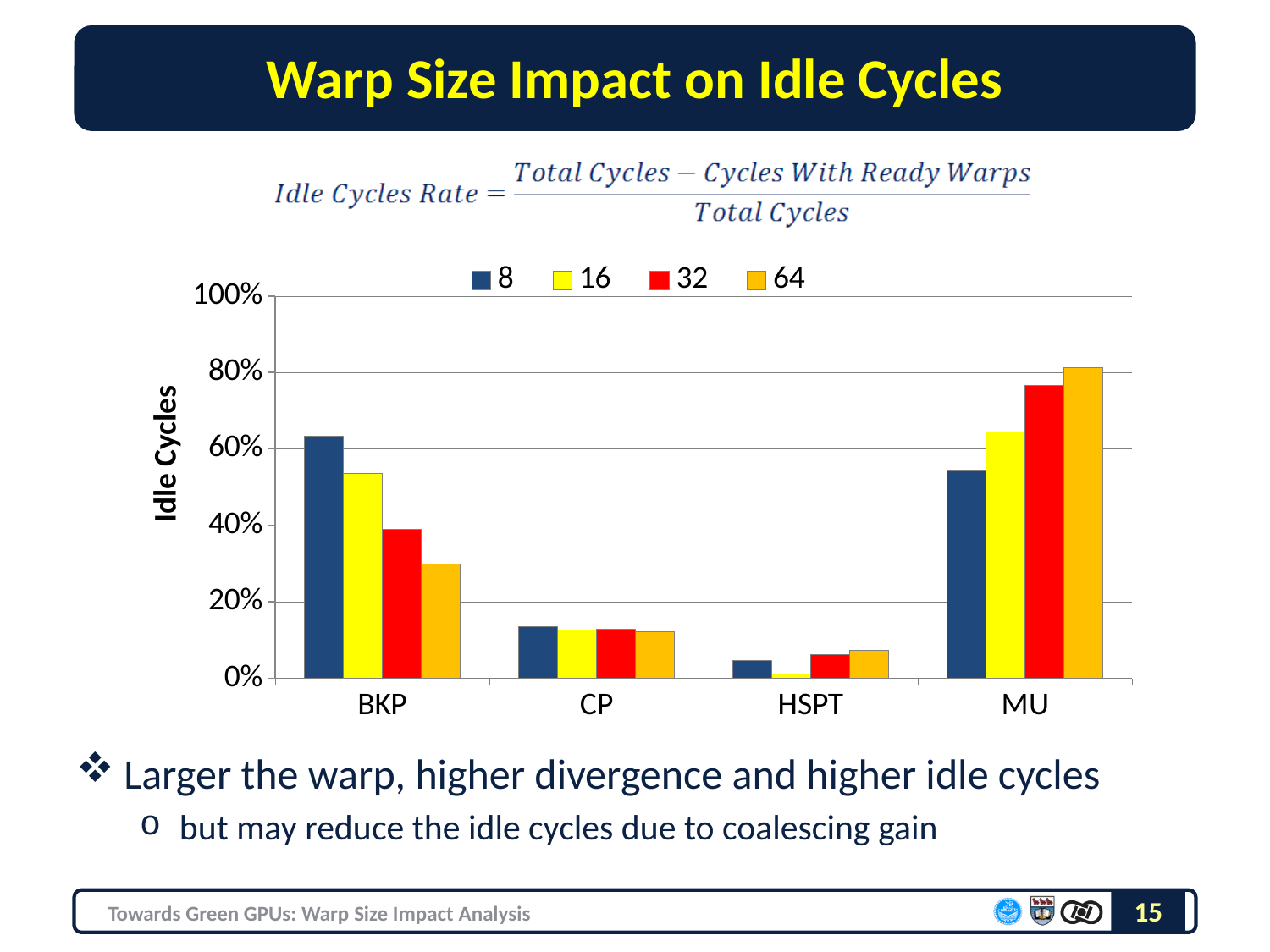
Which category has the lowest idle cycles value for warp size 8? HSPT What is the title of the y axis? Idle Cycles How many benchmark categories are shown on the x axis? 4 Is the idle cycles value for MU with warp size 32 greater or less than 60%? greater What kind of chart is shown on the slide? bar chart For MU, do the idle cycles values rise or fall as the warp size increases from 8 to 64? rise For BKP, which warp size has the larger idle cycles value, 8 or 64? 8 Is the idle cycles value for BKP with warp size 8 greater or less than 60%? greater Which category has the highest idle cycles value for warp size 64? MU How many series does the legend list? 4 For MU, which warp size has the larger idle cycles value, 8 or 64? 64 Is the idle cycles value for BKP with warp size 64 greater or less than 40%? less